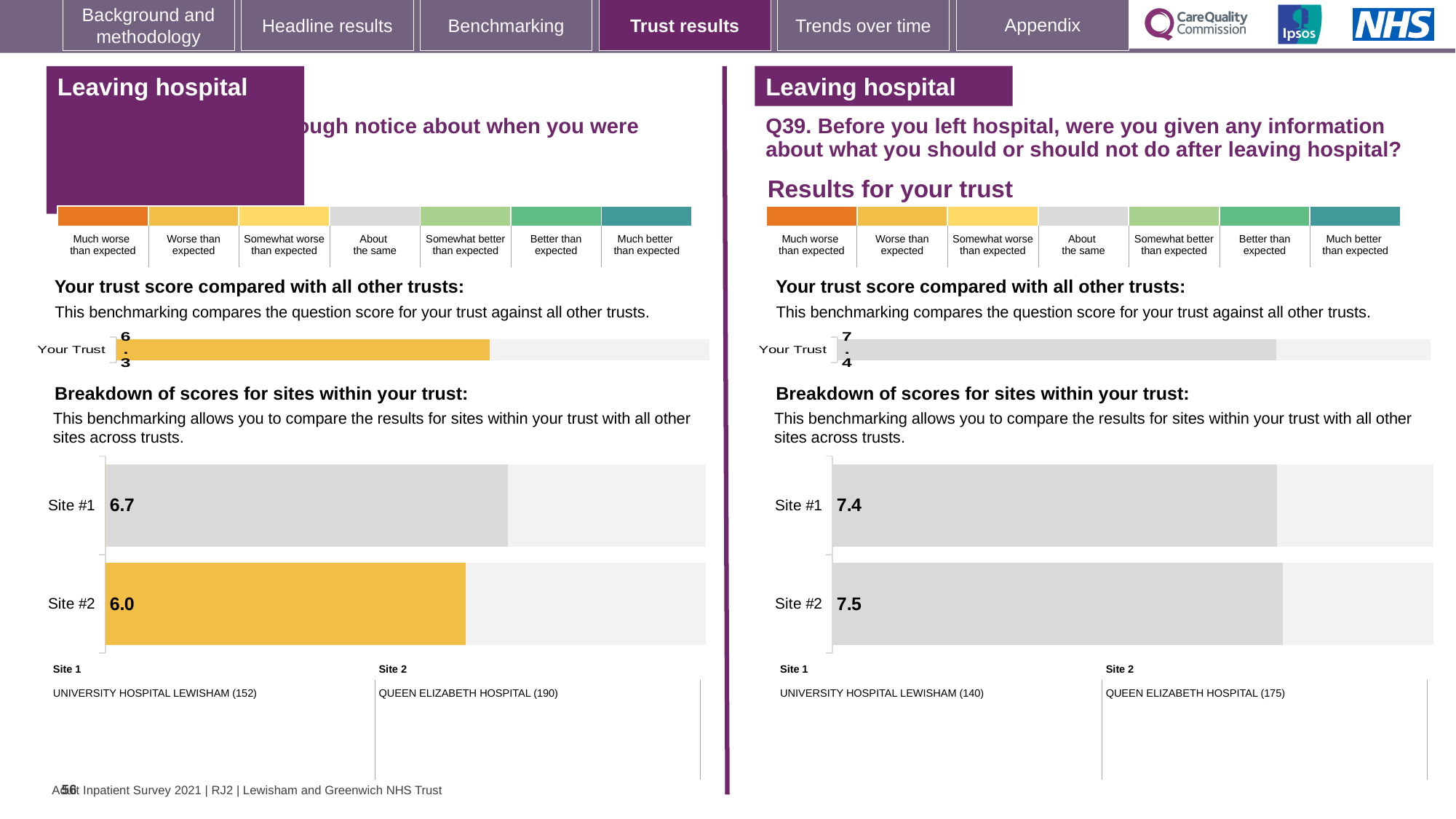
In the site breakdown chart on the right half of the slide (Q39), what is the score for Site #1? 7.4 In the 'Your Trust' chart on the left half of the slide, what is the trust score? 6.3 In the site breakdown chart on the left half of the slide, what colour is the Site #2 bar? Yellow In the 'Your Trust' chart on the right half of the slide (Q39), what is the trust score? 7.4 In the site breakdown chart on the right half of the slide (Q39), what is the score for Site #2? 7.5 In the site breakdown chart on the right half of the slide (Q39), what is the difference between the Site #2 and Site #1 scores? 0.1 What type of chart is used for the site breakdown on the left half of the slide? Bar chart In the site breakdown chart on the left half of the slide, what is the score for Site #1? 6.7 In the site breakdown chart on the left half of the slide, what is the score for Site #2? 6.0 In the site breakdown chart on the left half of the slide, what is the difference between the Site #1 and Site #2 scores? 0.7 How many sites are shown in the site breakdown chart on the right half of the slide (Q39)? 2 In the site breakdown chart on the left half of the slide, which site has the higher score? Site #1